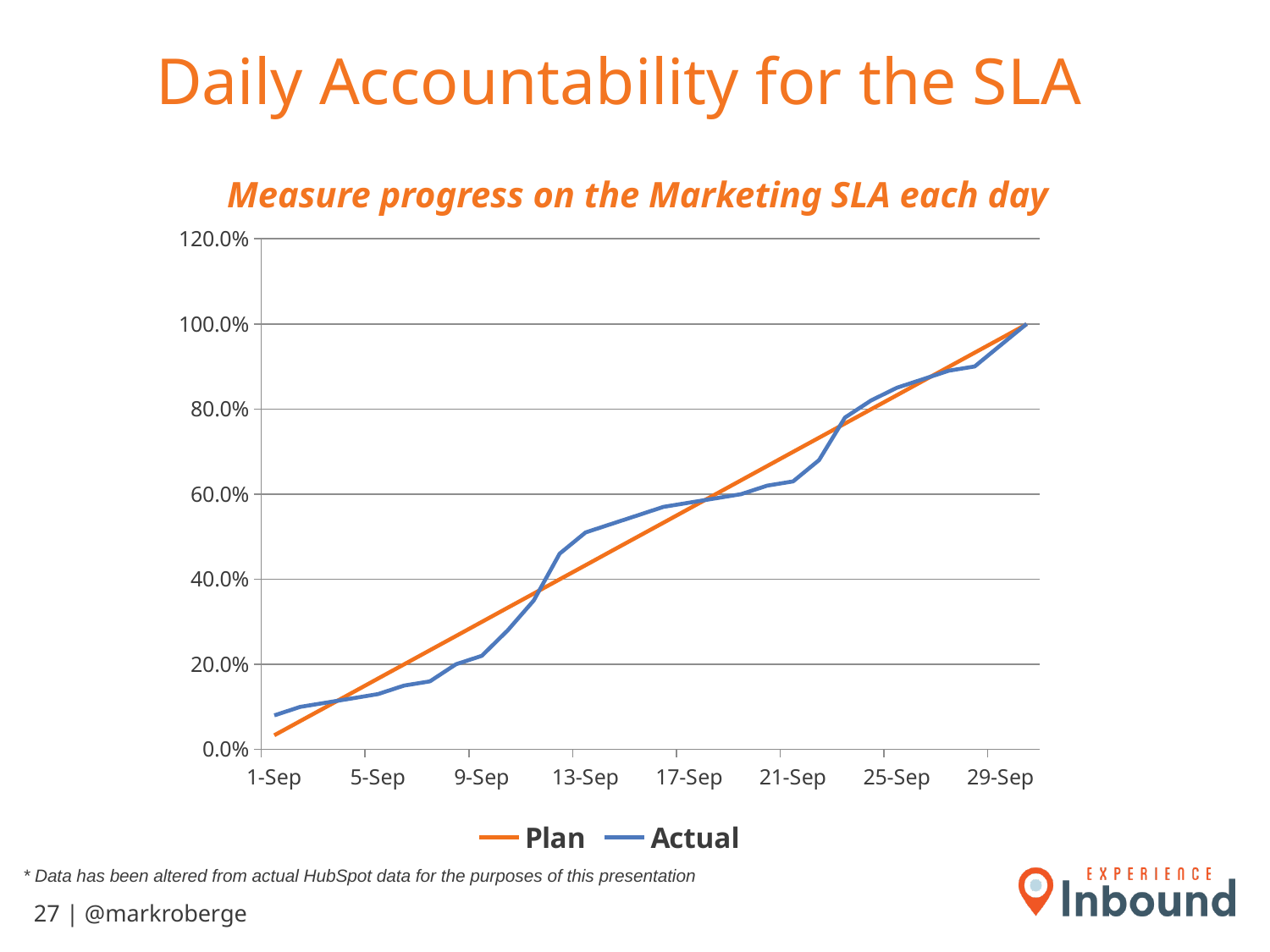
Is the Actual value on 1-Sep greater or less than 20.0%? less What kind of chart is shown on the slide? Line chart Is the Actual value on 13-Sep greater or less than 40.0%? greater How many series does the legend list? 2 What colour is the Actual line? Blue Do the values of the Plan line rise or fall from 1-Sep to the end of the month? Rise What are the names of the two series in the legend? Plan and Actual Is the Actual value on 25-Sep greater or less than 80.0%? greater On 9-Sep, which series has the higher value, Plan or Actual? Plan On 13-Sep, which series has the higher value, Plan or Actual? Actual What value do both the Plan and Actual lines reach at the end of the month? 100.0%